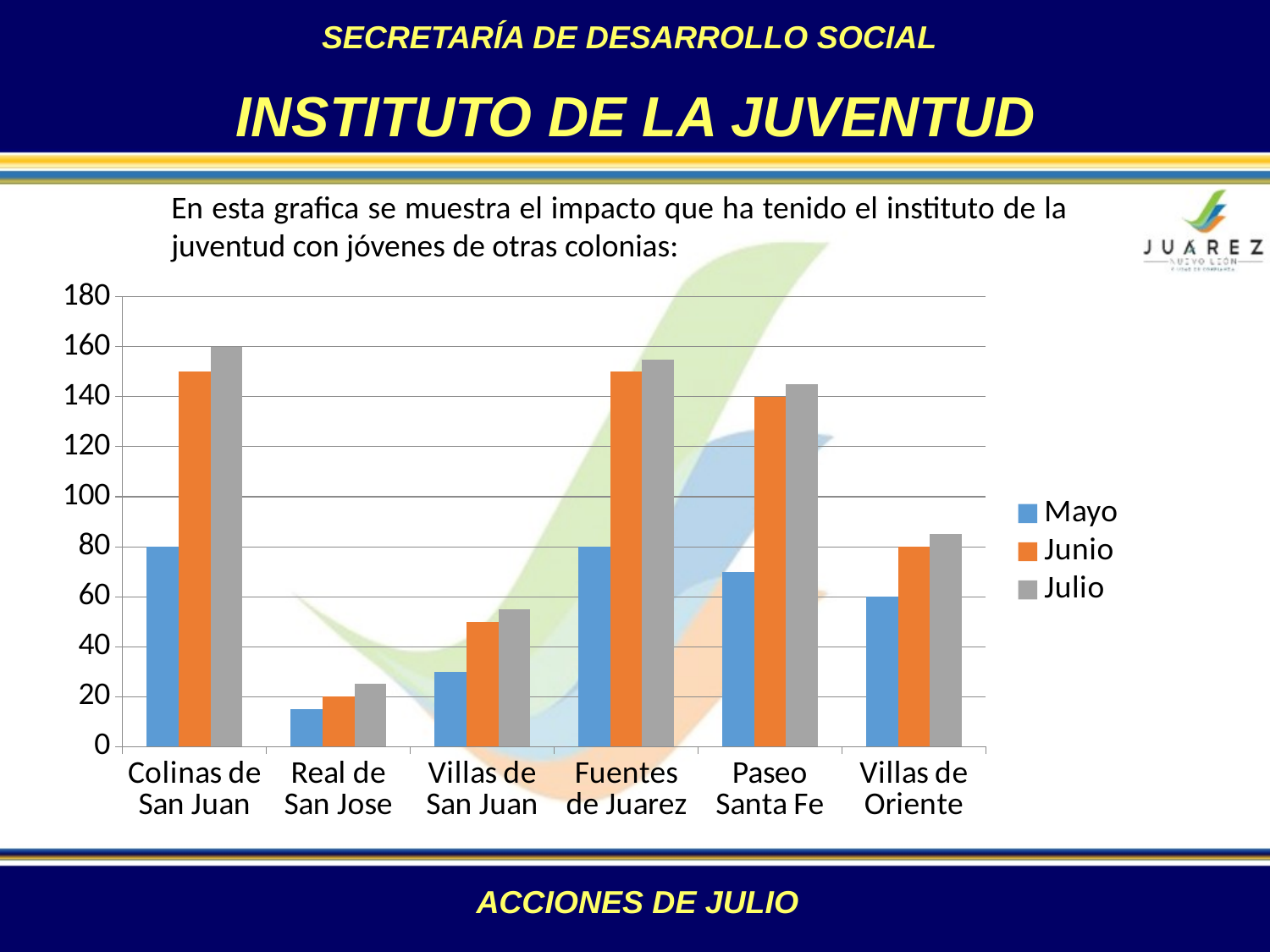
What is the difference between the Julio and Mayo values for Colinas de San Juan? 80 Is the Julio value for Villas de San Juan greater or less than 60? less Which colonia has the lowest Mayo value? Real de San Jose How many colonias (categories) are shown on the x axis? 6 What is the Mayo value for Villas de Oriente? 60 Is the Junio value for Colinas de San Juan greater or less than 140? greater What kind of chart is shown on the slide? Bar chart What is the Julio value for Colinas de San Juan? 160 What is the Junio value for Paseo Santa Fe? 140 Within each colonia, do the values rise or fall from Mayo to Julio? Rise What is the Mayo value for Colinas de San Juan? 80 How many series does the legend list? 3